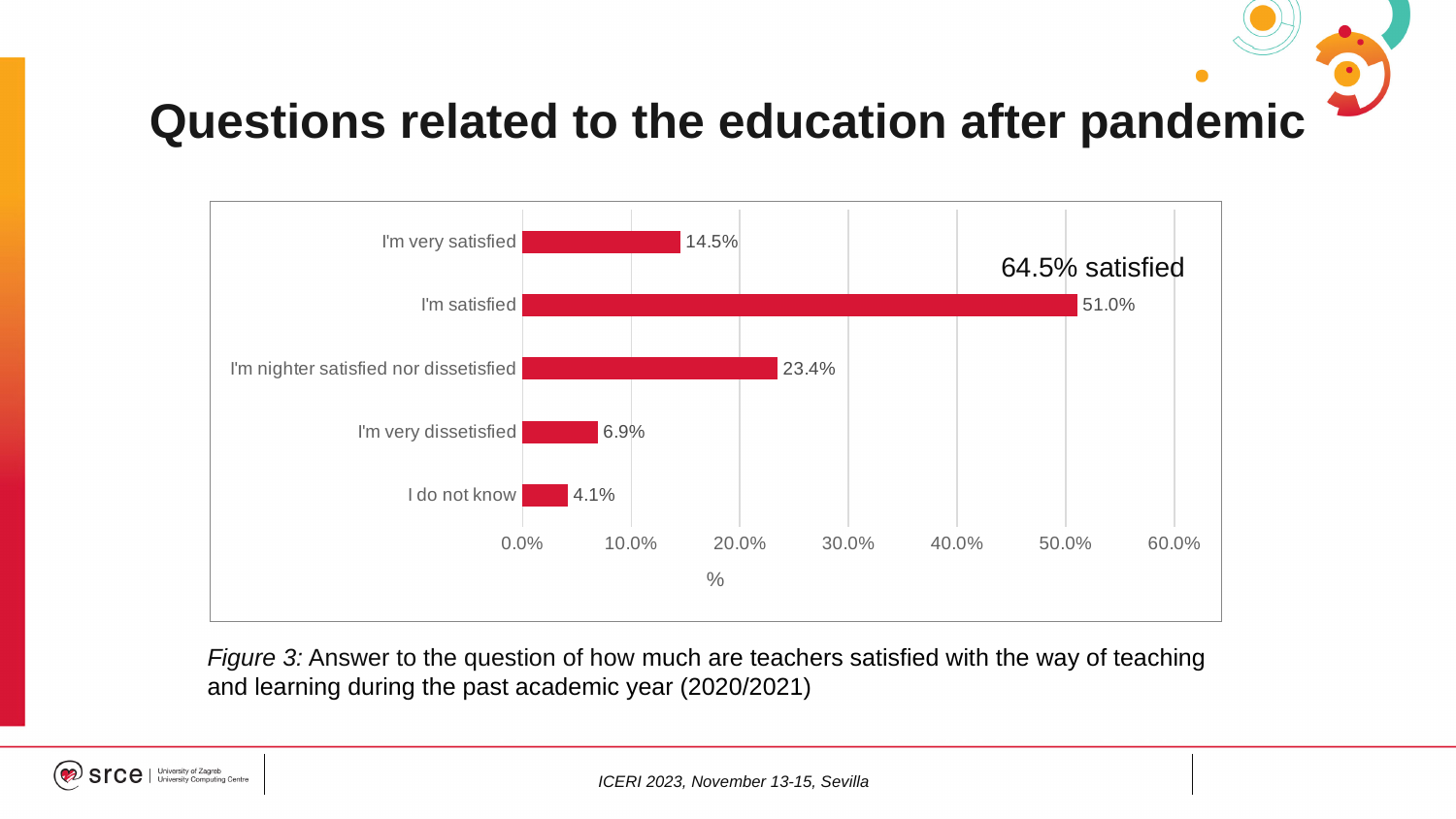
What percentage of teachers answered "I do not know"? 4.1% Which answer category has the lowest value? I do not know Is the value for "I'm satisfied" greater or less than 50.0%? greater What combined percentage of satisfied teachers is annotated on the chart? 64.5% satisfied What kind of chart is shown on the slide? Bar chart What percentage of teachers answered "I'm very satisfied"? 14.5% What is the difference between the values for "I'm satisfied" and "I'm very satisfied"? 36.5% What is the value for "I'm satisfied"? 51.0% What is the value for "I'm nighter satisfied nor dissetisfied"? 23.4% Which is larger, the value for "I'm very dissetisfied" or the value for "I do not know"? I'm very dissetisfied How many answer categories are shown in the chart? 5 Which answer category has the highest value? I'm satisfied